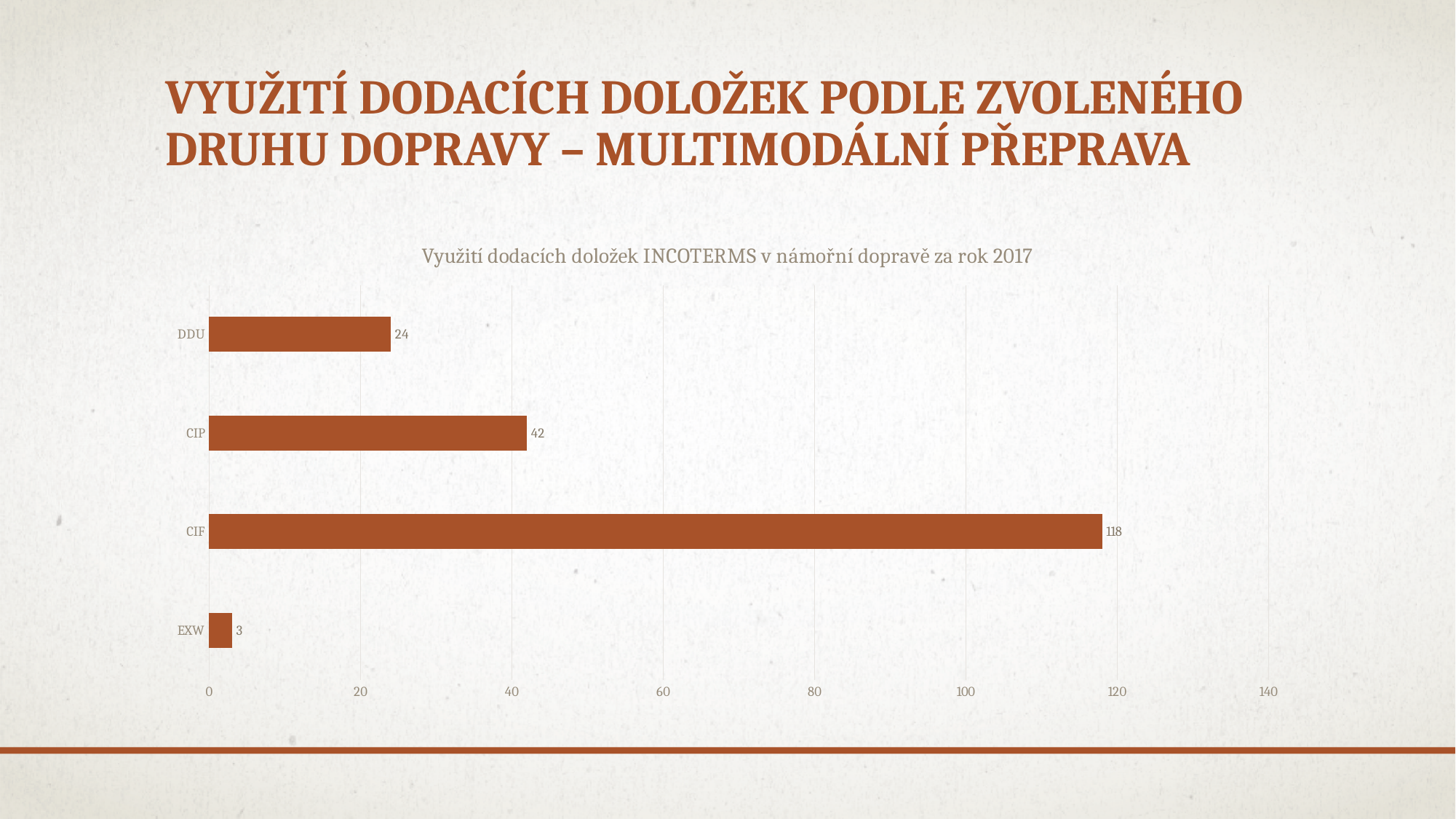
What is the value for DDU? 24 Which category has the highest value? CIF What is the difference between the values for CIP and DDU? 18 What is the title of the chart? Využití dodacích doložek INCOTERMS v námořní dopravě za rok 2017 What is the value for CIF? 118 What kind of chart is shown on the slide? Bar chart What is the value for CIP? 42 What is the difference between the values for CIF and CIP? 76 What is the value for EXW? 3 Which is larger, the value for DDU or the value for CIP? CIP Which category has the lowest value? EXW How many categories are shown in the chart? 4